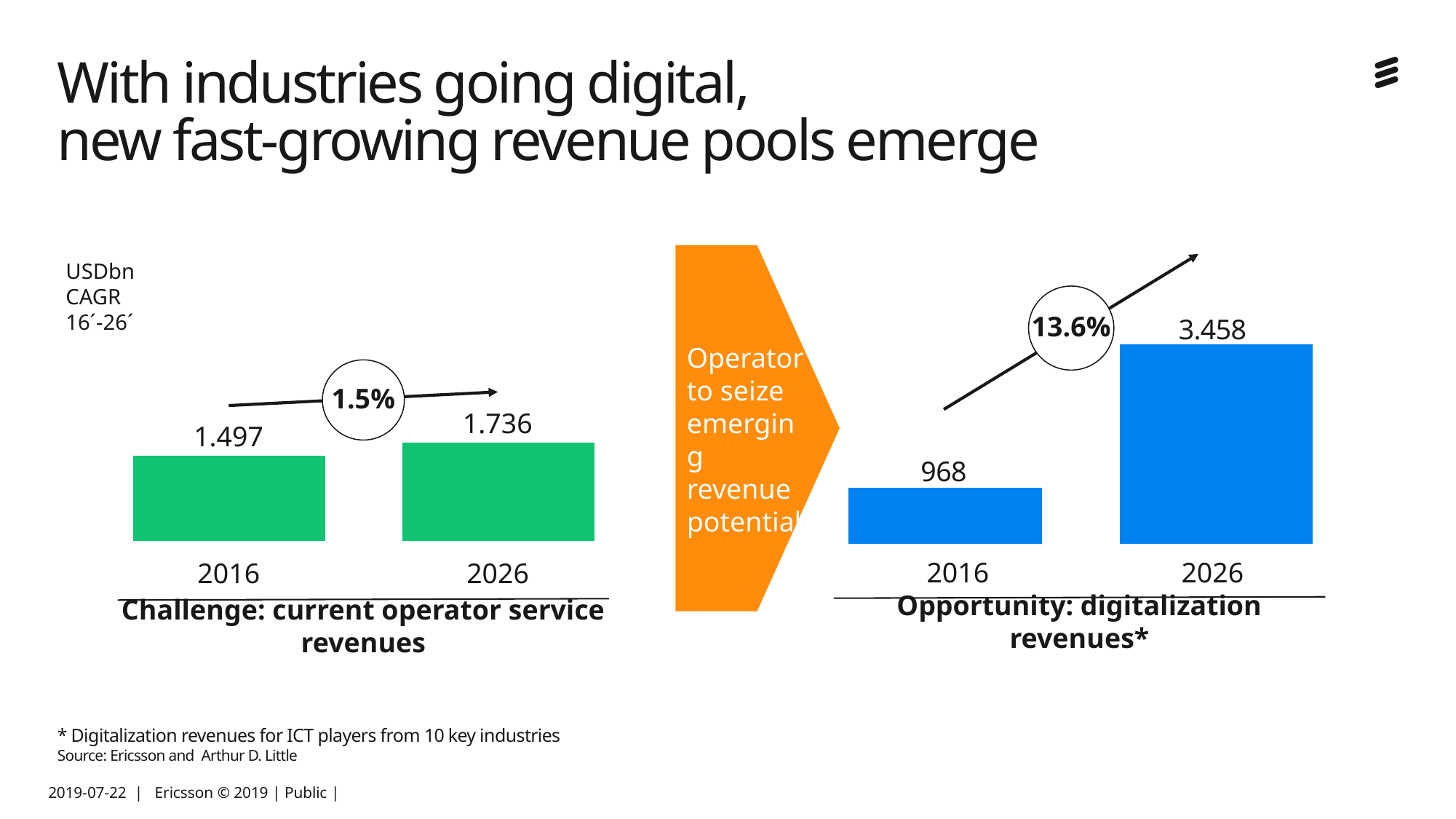
In the 'Opportunity: digitalization revenues*' chart, what is the value for 2026? 3.458 How many bars are in the 'Opportunity: digitalization revenues*' chart? 2 In the 'Opportunity: digitalization revenues*' chart, what is the value for 2016? 968 In the 'Challenge: current operator service revenues' chart, what is the value for 2026? 1.736 In the 'Opportunity: digitalization revenues*' chart, which year has the highest value? 2026 In the 'Challenge: current operator service revenues' chart, which year has the lowest value? 2016 What CAGR is shown on the 'Challenge: current operator service revenues' chart? 1.5% In the 'Challenge: current operator service revenues' chart, what is the value for 2016? 1.497 What CAGR is shown on the 'Opportunity: digitalization revenues*' chart? 13.6% In the 'Opportunity: digitalization revenues*' chart, which is larger, the value for 2016 or the value for 2026? 2026 What kind of chart is the 'Challenge: current operator service revenues' chart? Bar chart In the 'Challenge: current operator service revenues' chart, do the values rise or fall from 2016 to 2026? Rise